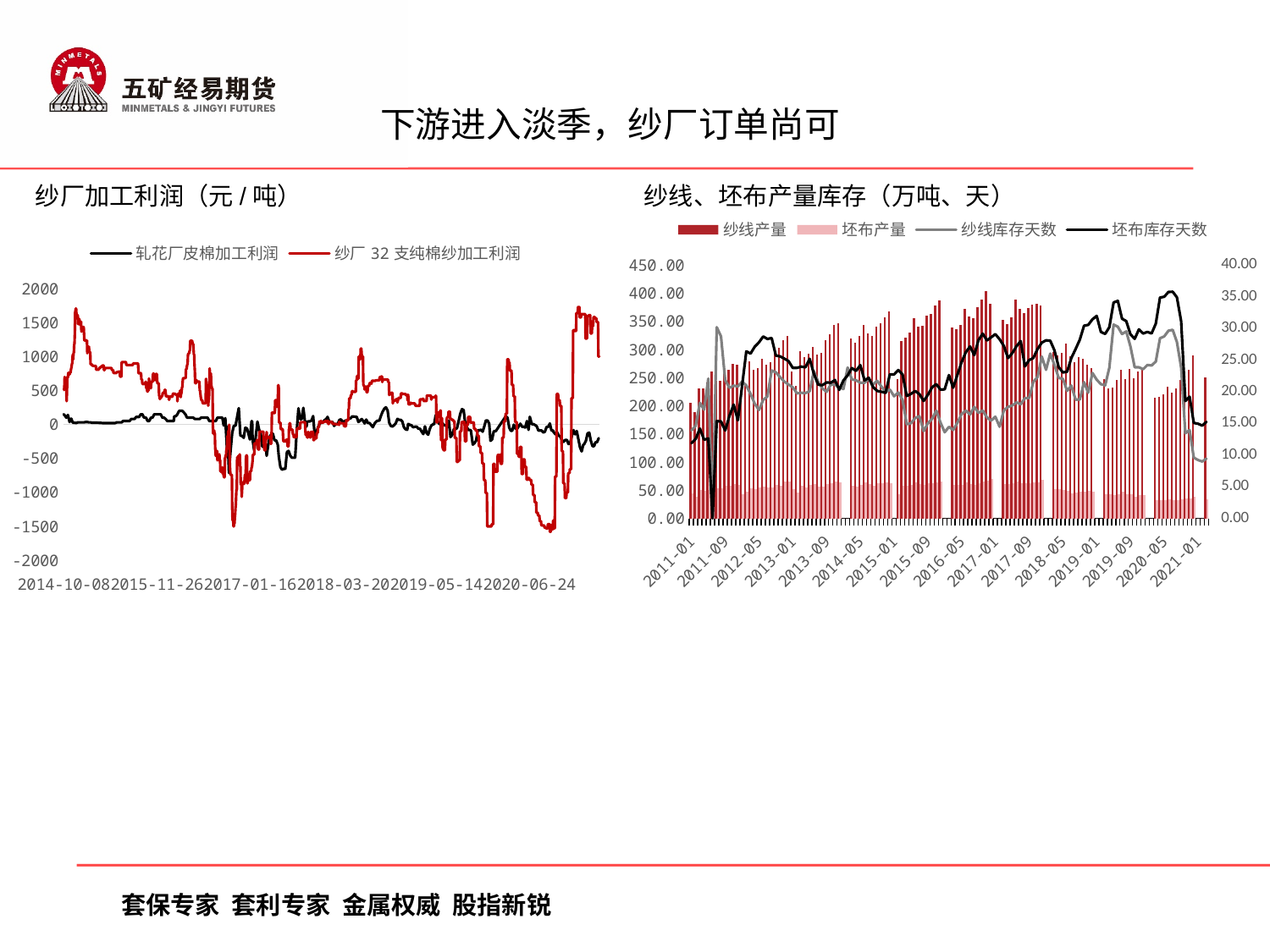
How many series does the legend of the right chart '纱线、坯布产量库存（万吨、天）' list? 4 In the left chart '纱厂加工利润（元/吨）', is the highest value of 纱厂32支纯棉纱加工利润 greater or less than 1500? greater In the right chart '纱线、坯布产量库存（万吨、天）', is the highest 坯布产量 bar greater or less than 100.00? less In the right chart '纱线、坯布产量库存（万吨、天）', does 纱线库存天数 rise or fall between 2020-05 and 2021-01? fall What kind of chart is the right chart '纱线、坯布产量库存（万吨、天）'? Combination bar and line chart In the left chart '纱厂加工利润（元/吨）', which colour is used for the 纱厂32支纯棉纱加工利润 line? Red What is the title of the right chart on the slide? 纱线、坯布产量库存（万吨、天） What kind of chart is the left chart '纱厂加工利润（元/吨）'? Line chart In the right chart '纱线、坯布产量库存（万吨、天）', is the peak value of 坯布库存天数 greater or less than 30.00? greater How many series does the legend of the left chart '纱厂加工利润（元/吨）' list? 2